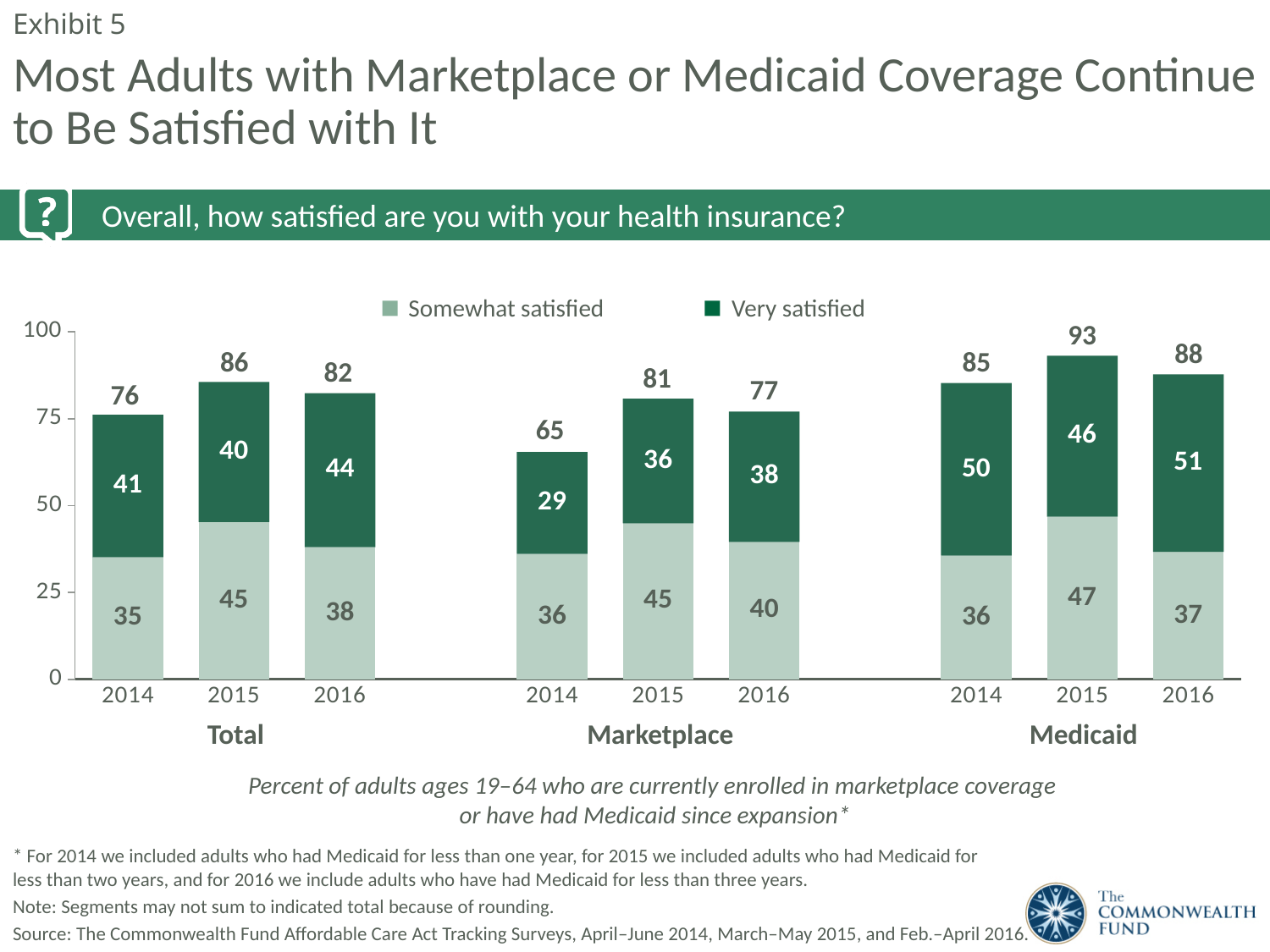
What question is shown in the banner above the chart? Overall, how satisfied are you with your health insurance? Which bar has the highest total shown? Medicaid 2015 What kind of chart is shown on the slide? Stacked bar chart Which is larger: the 'Very satisfied' value for Total 2016 or for Marketplace 2016? Total 2016 What is the 'Somewhat satisfied' value for Marketplace in 2015? 45 Do the totals for Marketplace rise or fall from 2014 to 2015? Rise What is the difference between the totals for Medicaid 2015 and Medicaid 2016? 5 How many series does the legend list? 2 How many bars are plotted in the chart? 9 Which bar has the lowest total shown? Marketplace 2014 What is the total printed above the Total 2014 bar? 76 What is the 'Very satisfied' value for Medicaid in 2016? 51